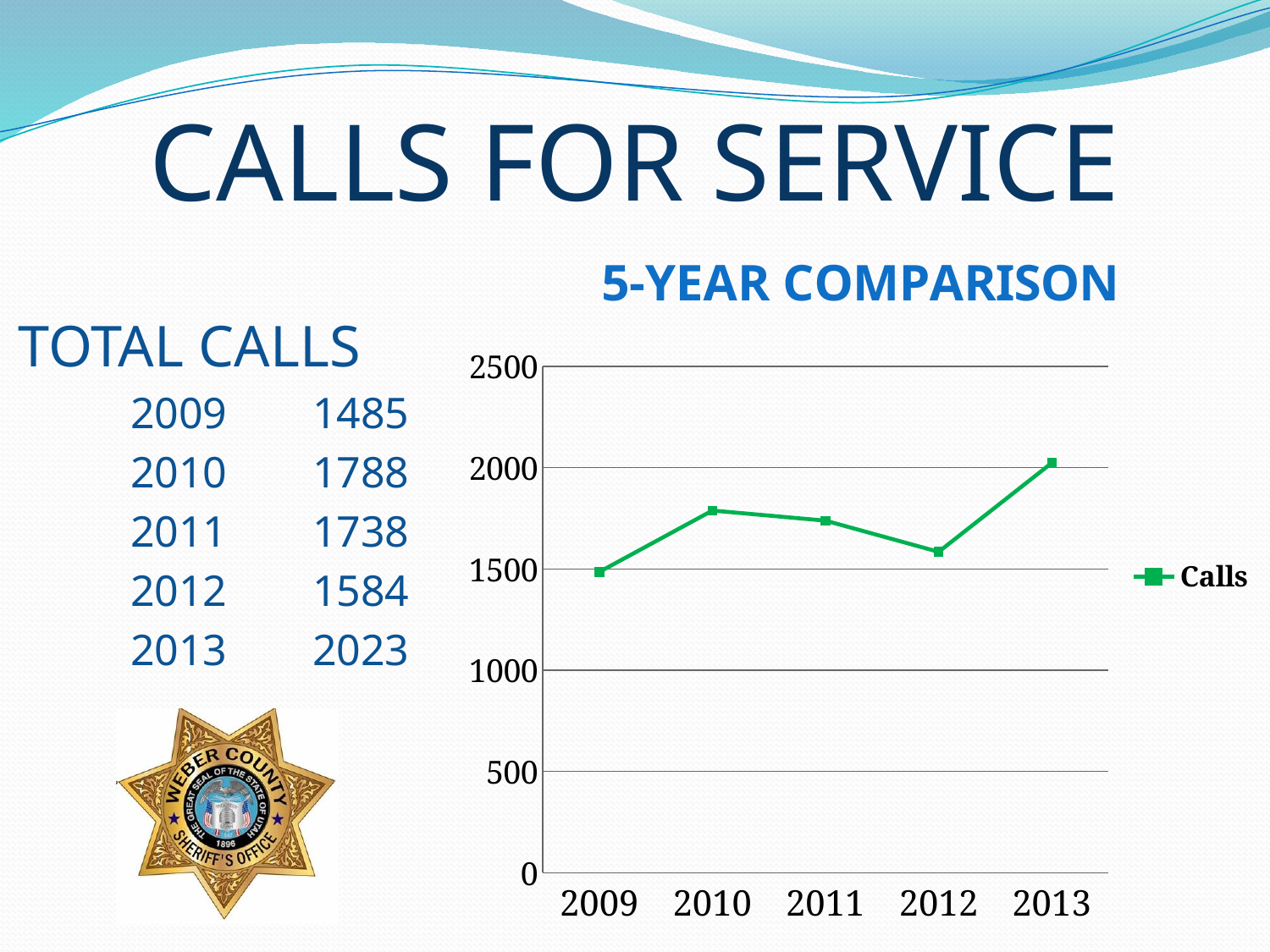
What is the difference in calls between 2013 and 2012? 439 How many years are plotted on the x axis of the chart? 5 What is the number of calls for 2013? 2023 Which year has the highest number of calls? 2013 What is the name of the series in the chart legend? Calls Is the value for 2013 greater or less than 2000? greater What is the number of calls for 2009? 1485 Which year has the lowest number of calls? 2009 How many series does the chart legend list? 1 What kind of chart is shown on the slide? line chart What is the title of the chart? 5-YEAR COMPARISON Which year had more calls, 2010 or 2012? 2010